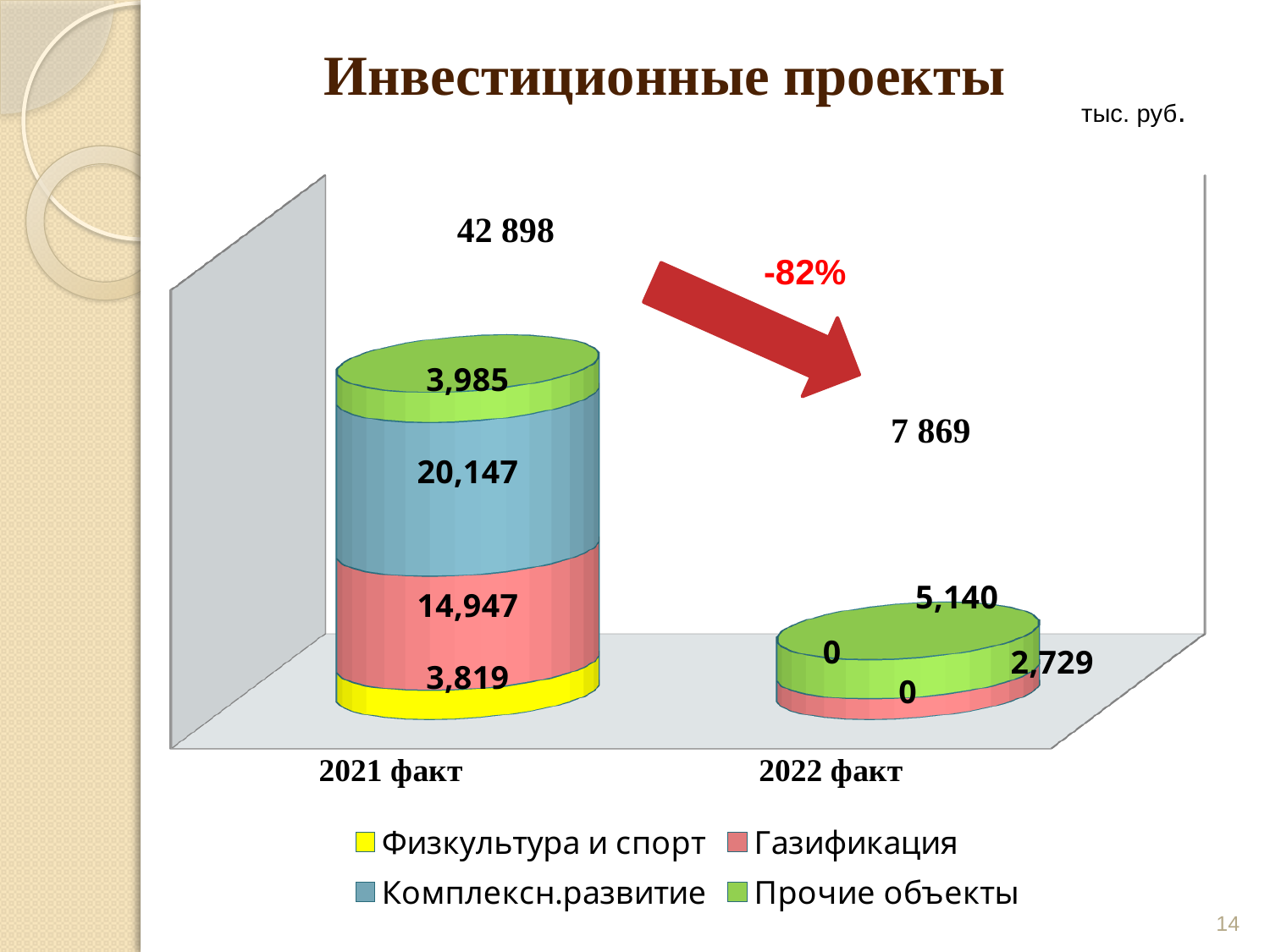
What percentage change is shown by the red arrow between 2021 факт and 2022 факт? -82% What is the total of the stacked bar for 2022 факт? 7 869 What is the value for Комплексн.развитие in 2021 факт? 20,147 How many series does the legend list? 4 What is the total of the stacked bar for 2021 факт? 42 898 What is the value for Газификация in 2022 факт? 2,729 What is the difference between Комплексн.развитие and Газификация in 2021 факт? 5,200 What is the value for Прочие объекты in 2022 факт? 5,140 Which is larger in 2022 факт: Прочие объекты or Газификация? Прочие объекты What is the value for Физкультура и спорт in 2021 факт? 3,819 What is the value for Газификация in 2021 факт? 14,947 Which series has the largest value in 2021 факт? Комплексн.развитие